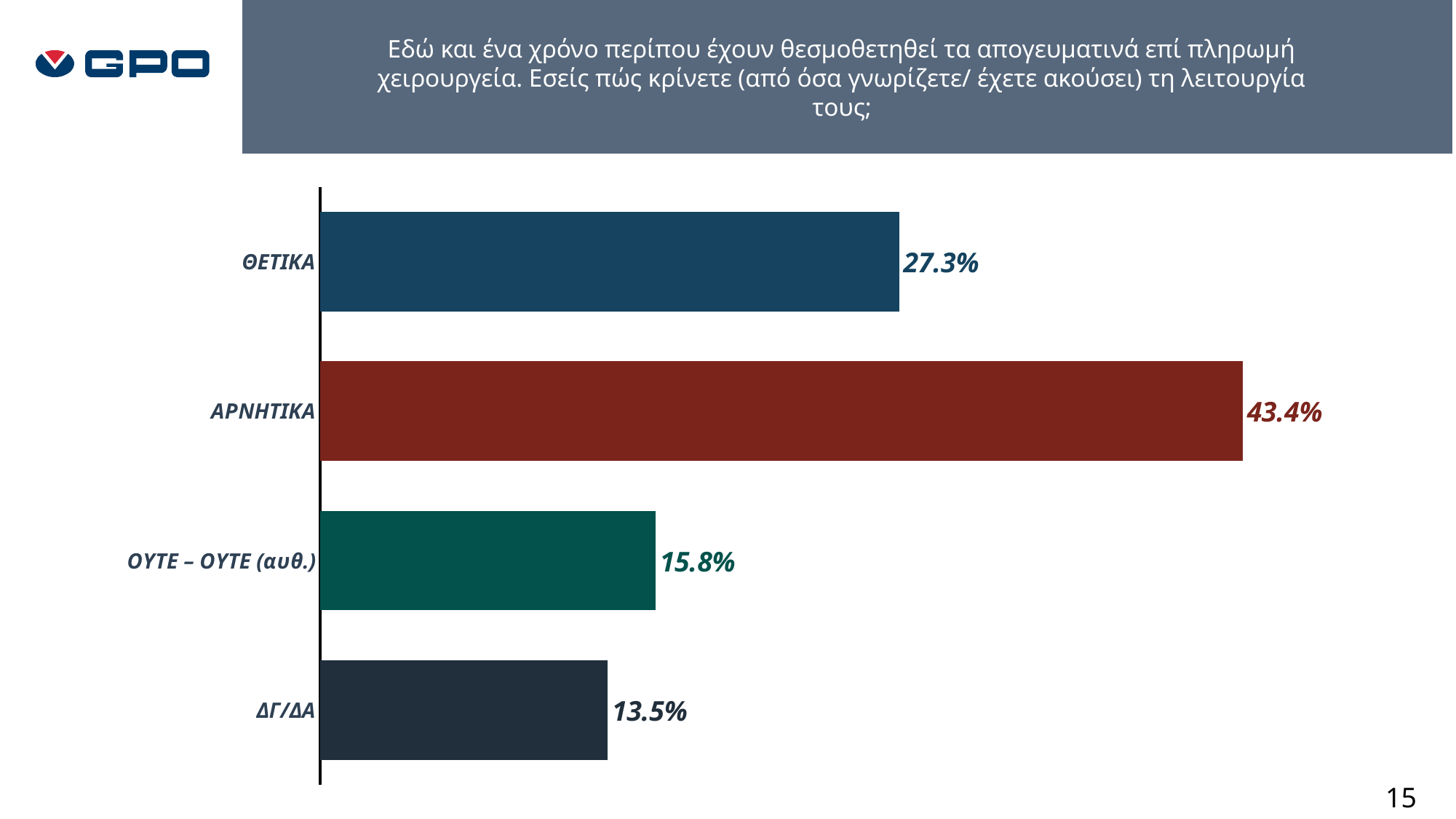
What is the value for ΟΥΤΕ – ΟΥΤΕ (αυθ.)? 15.8% What kind of chart is shown on the slide? Bar chart How many categories are shown in the chart? 4 What is the difference between the values for ΑΡΝΗΤΙΚΑ and ΘΕΤΙΚΑ? 16.1% What is the difference between the values for ΟΥΤΕ – ΟΥΤΕ (αυθ.) and ΔΓ/ΔΑ? 2.3% What is the value for ΘΕΤΙΚΑ? 27.3% What is the value for ΔΓ/ΔΑ? 13.5% Which category has the lowest value? ΔΓ/ΔΑ Which is larger, the value for ΘΕΤΙΚΑ or the value for ΑΡΝΗΤΙΚΑ? ΑΡΝΗΤΙΚΑ What colour is the bar for ΑΡΝΗΤΙΚΑ? Dark red Which category has the highest value? ΑΡΝΗΤΙΚΑ What is the value for ΑΡΝΗΤΙΚΑ? 43.4%